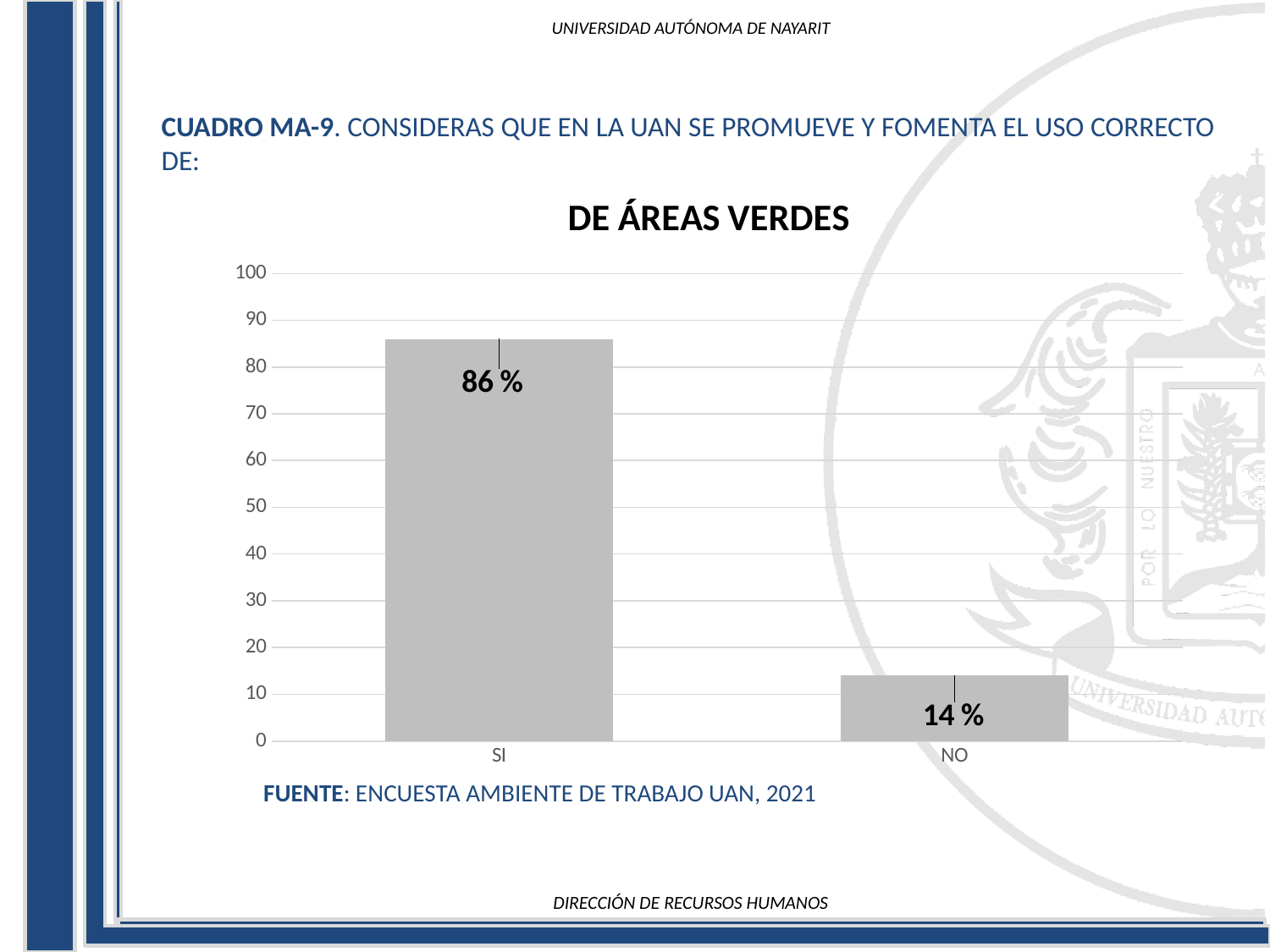
Is the value for SI greater or less than 80? greater What kind of chart is shown on the slide? bar chart What is the value for NO? 14 % What is the title of the chart? DE ÁREAS VERDES What is the value for SI? 86 % How many categories are shown on the x axis? 2 What is the highest value shown on the y axis? 100 What is the difference between the values for SI and NO? 72 % Which category has the highest value? SI Which category has the lowest value? NO Is the value for NO greater or less than 20? less Which is larger, the value for SI or the value for NO? SI